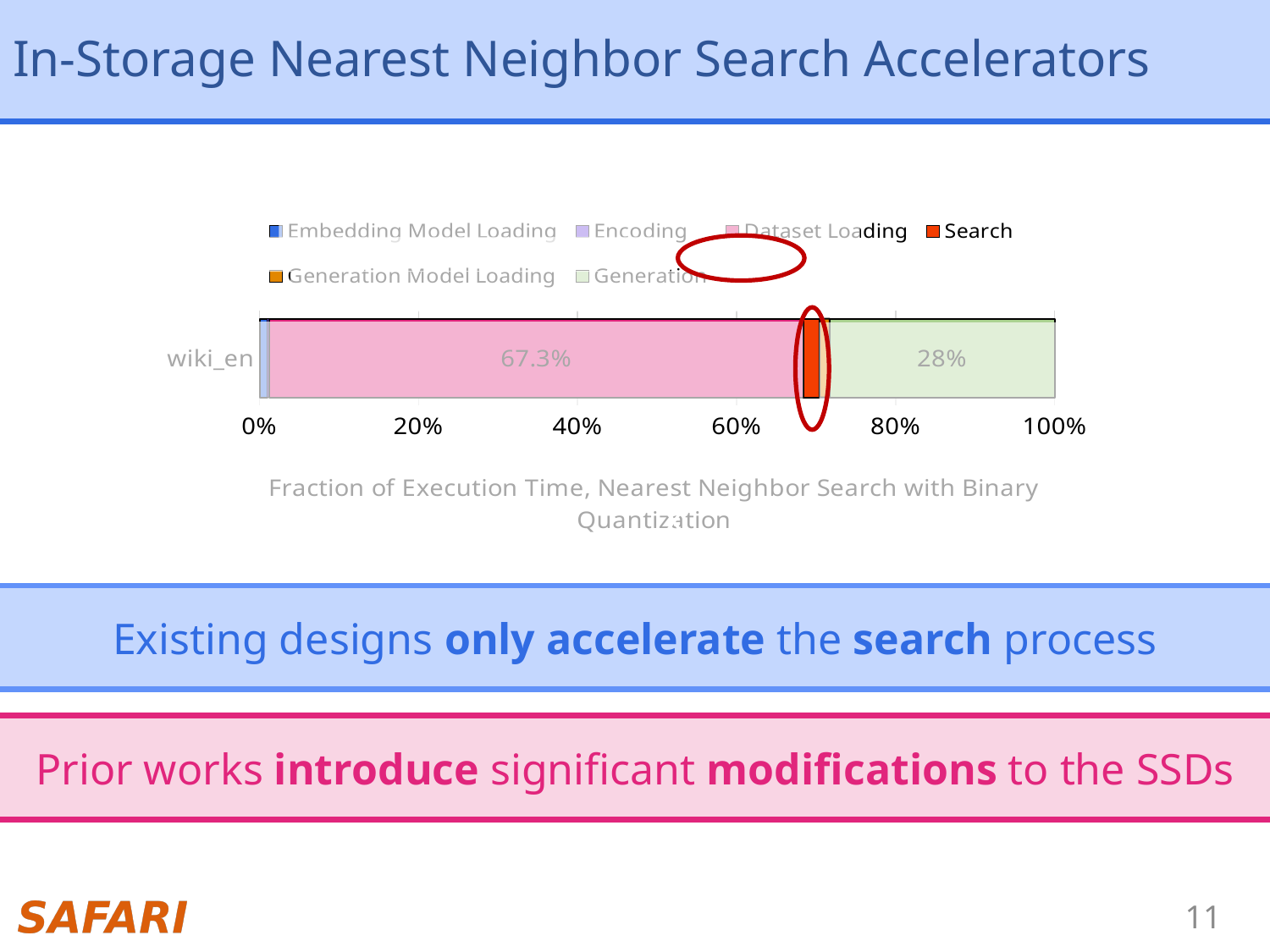
Which legend entry is circled in red? Search What is the value for Dataset Loading for wiki_en? 67.3% How many categories are plotted on the y axis? 1 What kind of chart is shown on the slide? Stacked bar chart How many series does the legend list? 6 What is the value for Generation for wiki_en? 28% Is the value for Dataset Loading greater or less than 60%? greater Is the value for Generation greater or less than 40%? less Which series takes the largest share of the wiki_en bar? Dataset Loading What is the caption below the chart's x axis? Fraction of Execution Time, Nearest Neighbor Search with Binary Quantization What is the difference between the Dataset Loading value and the Generation value for wiki_en? 39.3 percentage points Which is larger for wiki_en, Dataset Loading or Generation? Dataset Loading